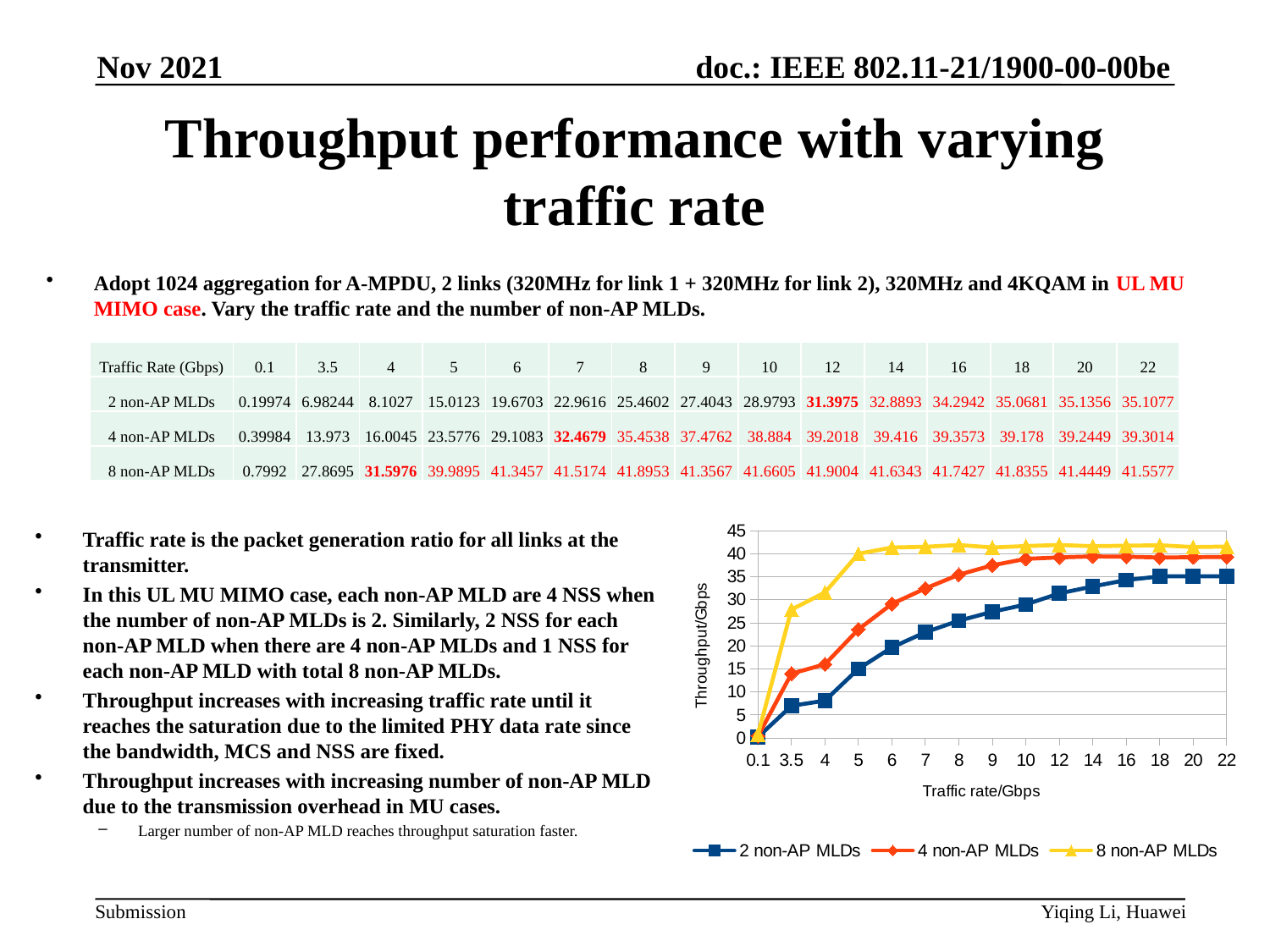
Is the throughput for 2 non-AP MLDs at a traffic rate of 22 Gbps greater or less than 40? less What is the label on the x axis of the chart? Traffic rate/Gbps How many traffic rate points are plotted along the x axis of the chart? 15 Is the throughput for 8 non-AP MLDs at a traffic rate of 5 Gbps greater or less than 35? greater At a traffic rate of 6 Gbps, which series has the higher throughput: 2 non-AP MLDs or 4 non-AP MLDs? 4 non-AP MLDs How many series does the chart legend list? 3 Which series has the highest throughput at a traffic rate of 3.5 Gbps? 8 non-AP MLDs At which traffic rate do all three series have their lowest throughput? 0.1 What kind of chart is shown on the slide? Line chart Does throughput rise or fall as the traffic rate increases along the x axis? Rise What is the throughput for 2 non-AP MLDs at a traffic rate of 22 Gbps, as given in the table? 35.1077 What is the throughput for 8 non-AP MLDs at a traffic rate of 0.1 Gbps, as given in the table? 0.7992